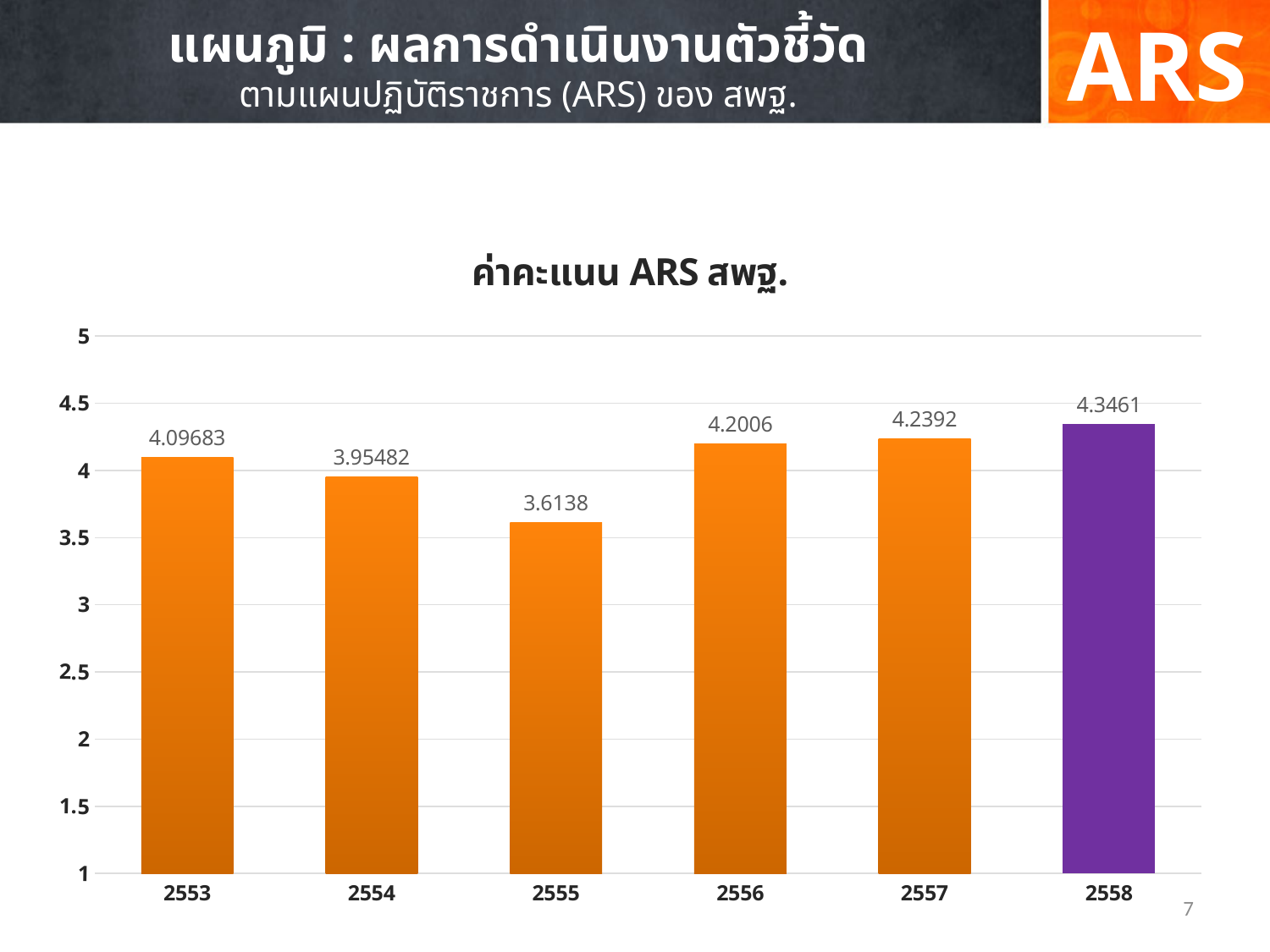
Which year has the highest value in the chart? 2558 What kind of chart is shown on the slide? bar chart What is the value for 2553 in the chart? 4.09683 From 2555 to 2558, do the values rise or fall? rise Is the value for 2555 greater or less than 4? less Which is larger, the value for 2553 or the value for 2554? 2553 What is the value for 2558 in the chart? 4.3461 What is the difference between the values for 2556 and 2555? 0.5868 How many years are shown on the x axis of the chart? 6 What is the difference between the values for 2558 and 2557? 0.1069 What is the value for 2555 in the chart? 3.6138 Which year has the lowest value in the chart? 2555